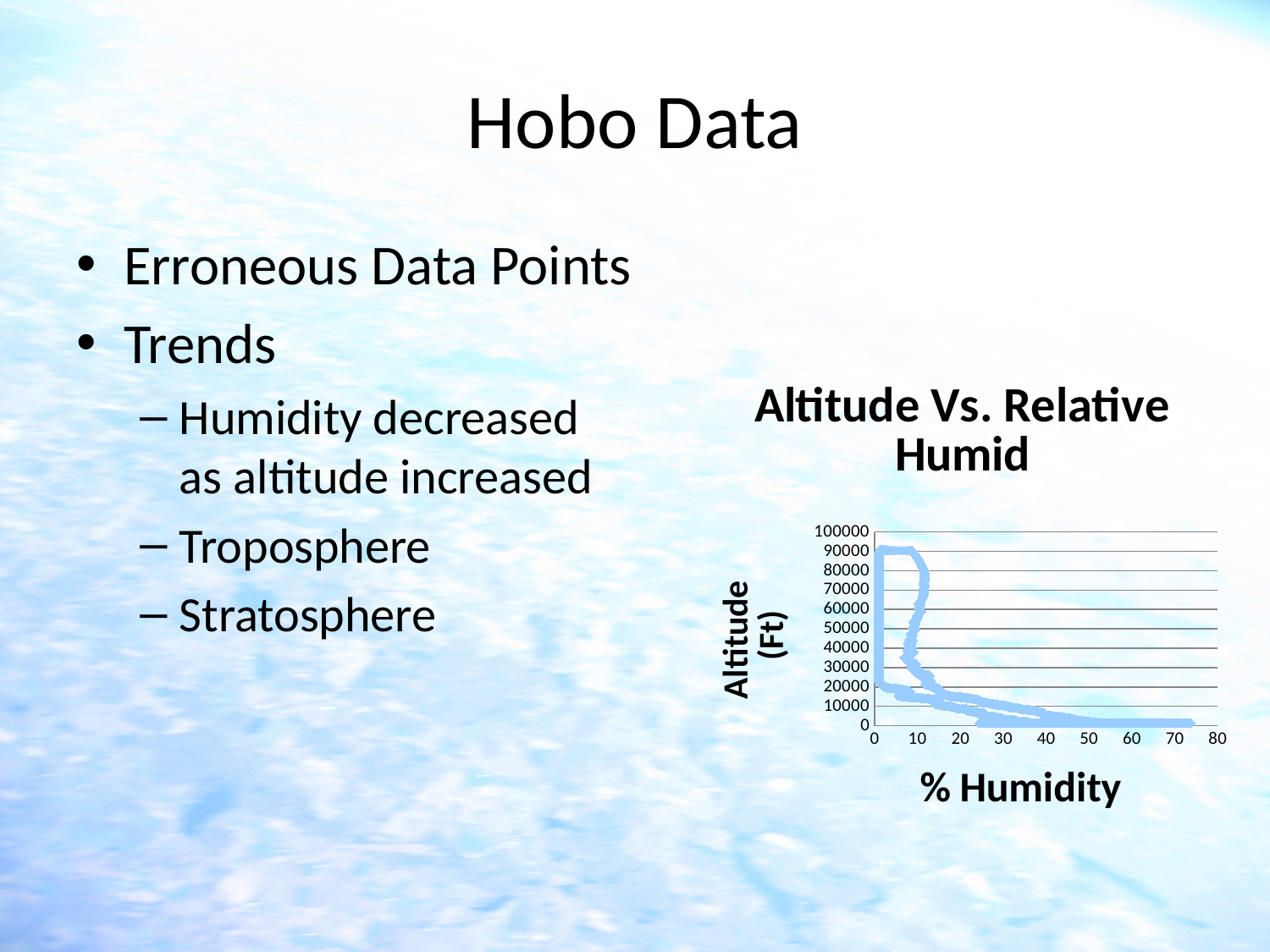
What is the highest value shown on the vertical (Altitude) axis of the chart? 100000 What is the highest value shown on the horizontal (% Humidity) axis of the chart? 80 What is the title of the chart on the slide? Altitude Vs. Relative Humid Is the highest altitude reached by the plotted points greater or less than 80000 ft? greater As altitude increases, does the % Humidity of the plotted points generally rise or fall? fall What is the label of the horizontal axis of the chart? % Humidity At altitudes above 40000 ft, is the % Humidity of the plotted points greater or less than 20? less Is the highest % Humidity value among the plotted points greater or less than 60? greater How many tick labels are shown on the vertical (Altitude) axis of the chart? 11 What kind of chart is shown on the slide? scatter chart